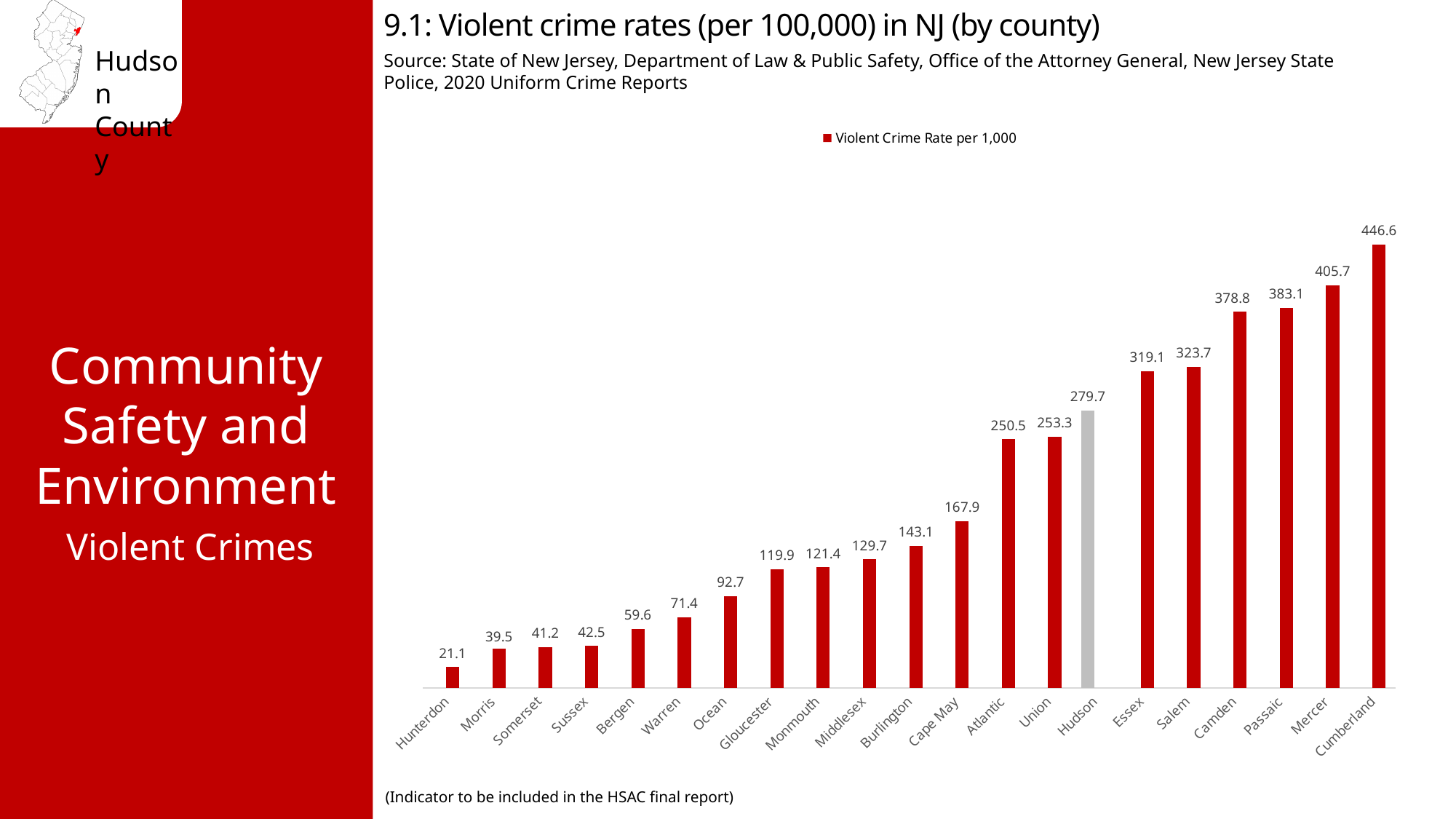
Which county has the highest violent crime rate? Cumberland What is the legend entry shown for the chart? Violent Crime Rate per 1,000 How many counties are shown in the chart? 21 What is the violent crime rate for Bergen? 59.6 What is the violent crime rate for Hudson County? 279.7 What is the difference between the violent crime rates of Cumberland and Hudson? 166.9 What is the violent crime rate for Cape May? 167.9 Which has a higher violent crime rate, Mercer or Camden? Mercer What is the difference between the violent crime rates of Hudson and Hunterdon? 258.6 Which has a higher violent crime rate, Ocean or Warren? Ocean What type of chart is shown on the slide? Bar chart Which county has the lowest violent crime rate? Hunterdon